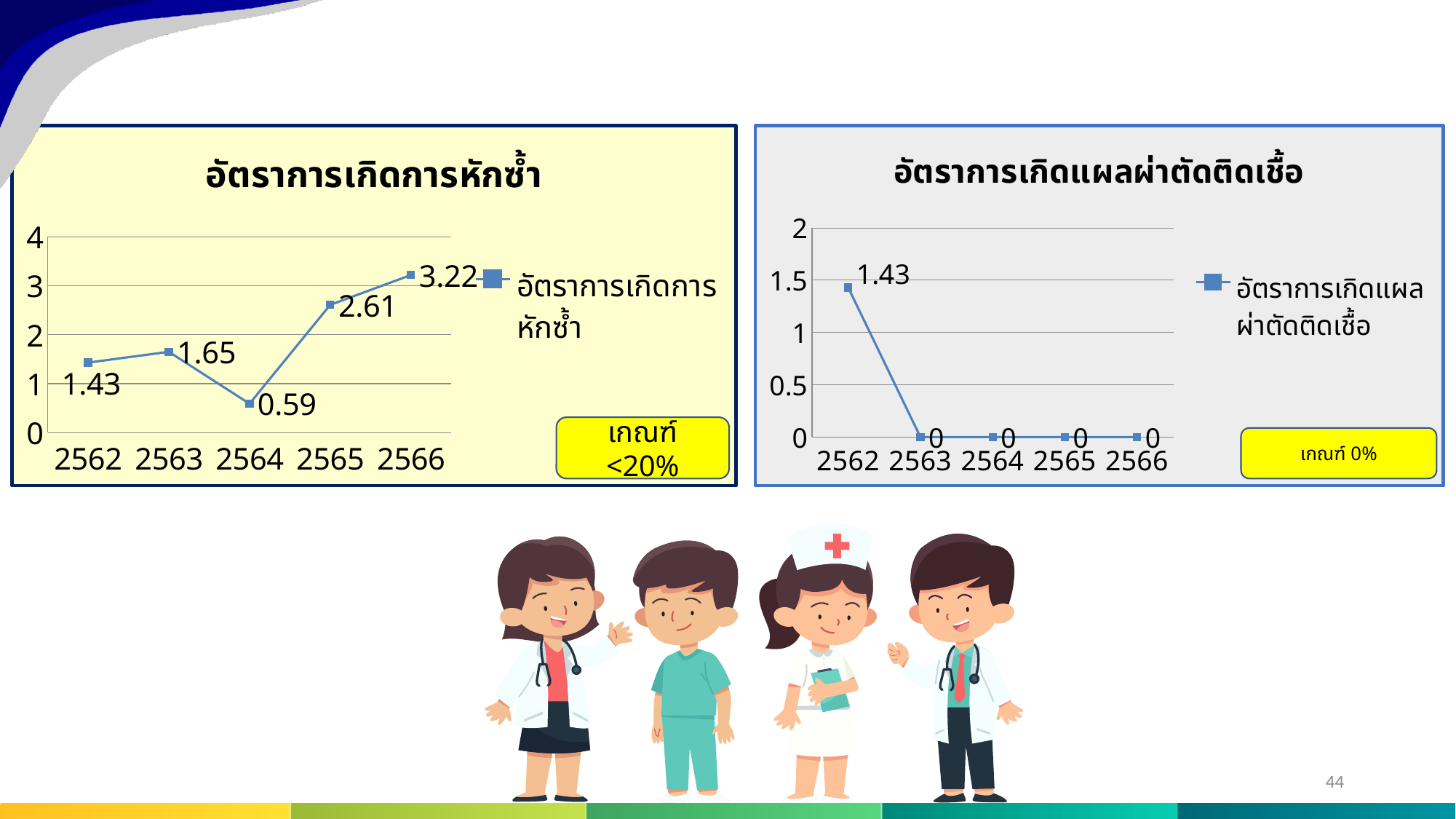
In the left chart (อัตราการเกิดการหักซ้ำ), which is larger, the value for 2563 or the value for 2562? 2563 In the left chart (อัตราการเกิดการหักซ้ำ), what is the value for 2564? 0.59 In the left chart (อัตราการเกิดการหักซ้ำ), which year has the lowest value? 2564 In the left chart (อัตราการเกิดการหักซ้ำ), what is the difference between the values for 2566 and 2565? 0.61 How many series does the legend of the right chart (อัตราการเกิดแผลผ่าตัดติดเชื้อ) list? 1 In the right chart (อัตราการเกิดแผลผ่าตัดติดเชื้อ), do the values rise or fall from 2562 to 2563? Fall In the left chart (อัตราการเกิดการหักซ้ำ), which year has the highest value? 2566 In the left chart (อัตราการเกิดการหักซ้ำ), how many years are plotted on the x axis? 5 What type of chart is the left chart (อัตราการเกิดการหักซ้ำ)? Line chart In the right chart (อัตราการเกิดแผลผ่าตัดติดเชื้อ), what is the value for 2562? 1.43 In the left chart (อัตราการเกิดการหักซ้ำ), what is the value for 2566? 3.22 In the right chart (อัตราการเกิดแผลผ่าตัดติดเชื้อ), what is the value for 2565? 0